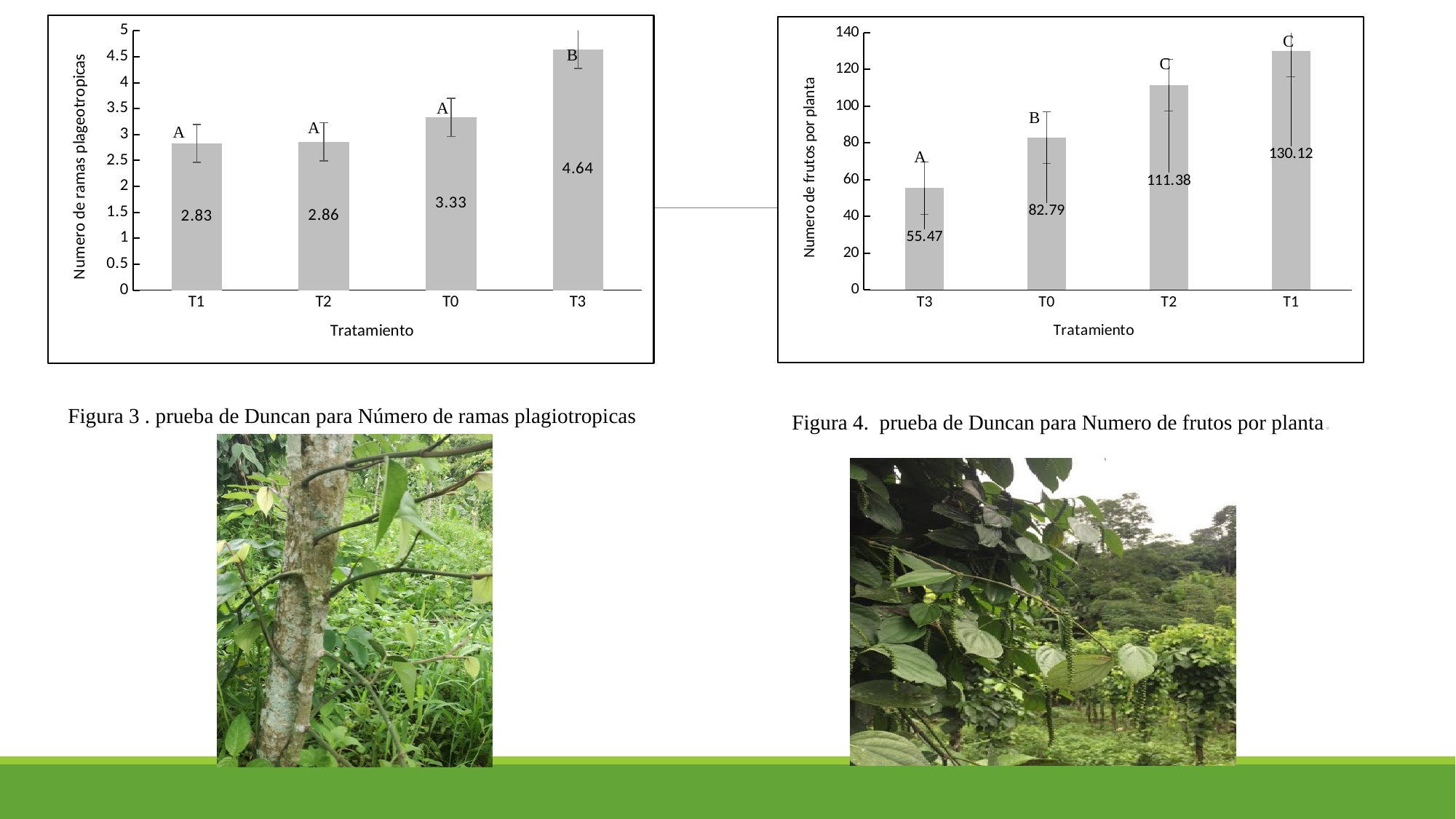
In the right chart (Figura 4), what is the value for T3? 55.47 In the left chart (Figura 3), what is the value for T3? 4.64 In the right chart (Figura 4), which treatment has the lowest number of frutos por planta? T3 In the right chart (Figura 4), what is the difference between the values for T1 and T2? 18.74 In the right chart (Figura 4), which is larger, the value for T0 or the value for T2? T2 In the left chart (Figura 3), how many treatments are shown on the x axis? 4 What kind of chart is the right chart (Figura 4)? bar chart In the left chart (Figura 3), which treatment has the highest number of ramas plageotropicas? T3 In the right chart (Figura 4), what is the value for T1? 130.12 In the left chart (Figura 3), what is the difference between the values for T3 and T0? 1.31 In the left chart (Figura 3), what is the value for T0? 3.33 In the left chart (Figura 3), do the bar values rise or fall from left to right along the x axis? rise